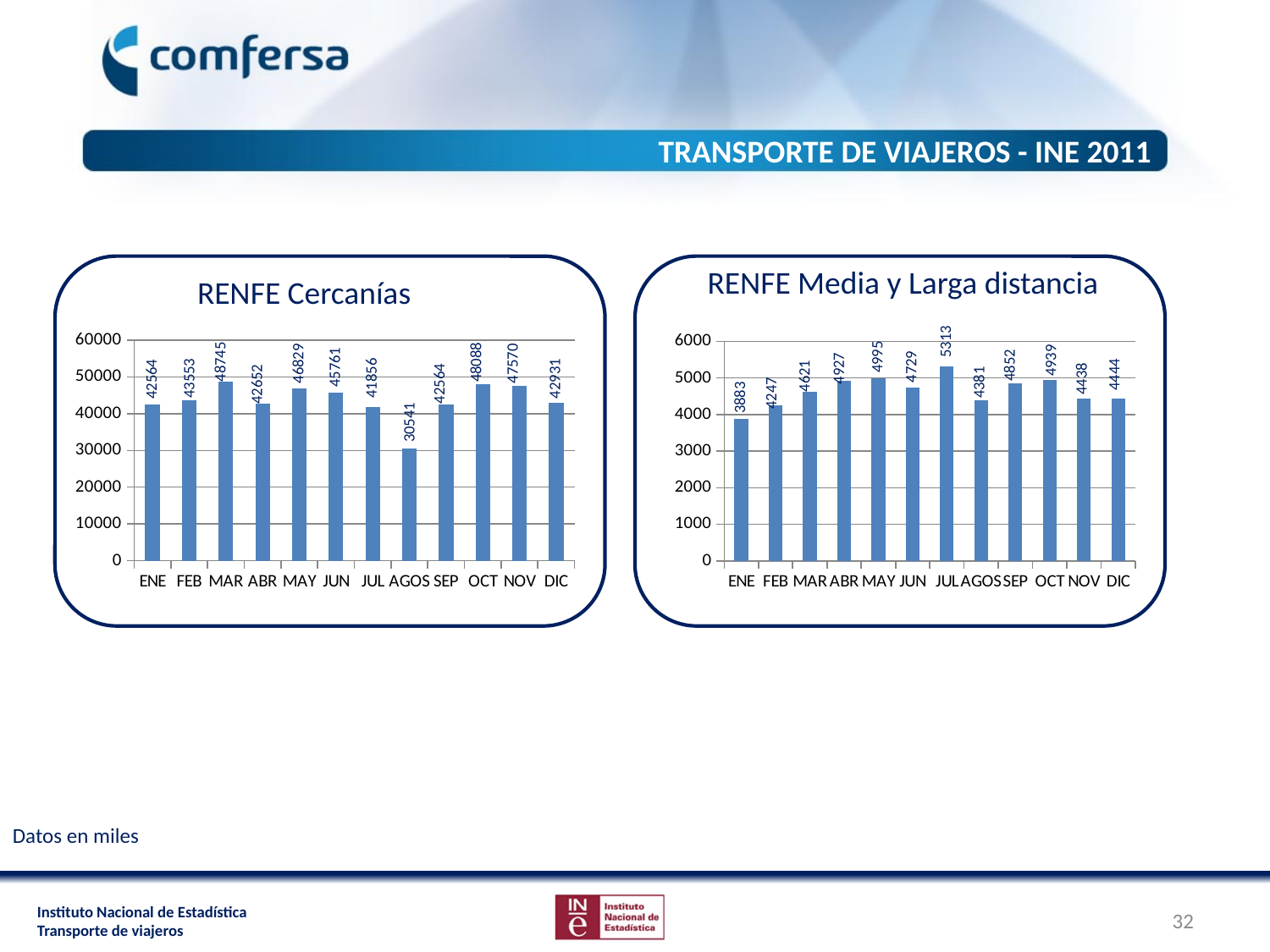
In the RENFE Media y Larga distancia chart, which is larger, the value for MAY or the value for JUN? MAY What kind of chart is the RENFE Cercanías chart? Bar chart In the RENFE Cercanías chart, what is the value for AGOS? 30541 In the RENFE Cercanías chart, how many months are plotted? 12 In the RENFE Cercanías chart, which month has the highest value? MAR In the RENFE Cercanías chart, which month has the lowest value? AGOS In the RENFE Cercanías chart, what is the difference between the values for OCT and NOV? 518 In the RENFE Media y Larga distancia chart, what is the difference between the values for JUL and ENE? 1430 In the RENFE Media y Larga distancia chart, is the value for AGOS greater or less than 5000? less In the RENFE Media y Larga distancia chart, what is the value for JUL? 5313 In the RENFE Media y Larga distancia chart, which month has the lowest value? ENE What is the title of the chart on the right of the slide? RENFE Media y Larga distancia